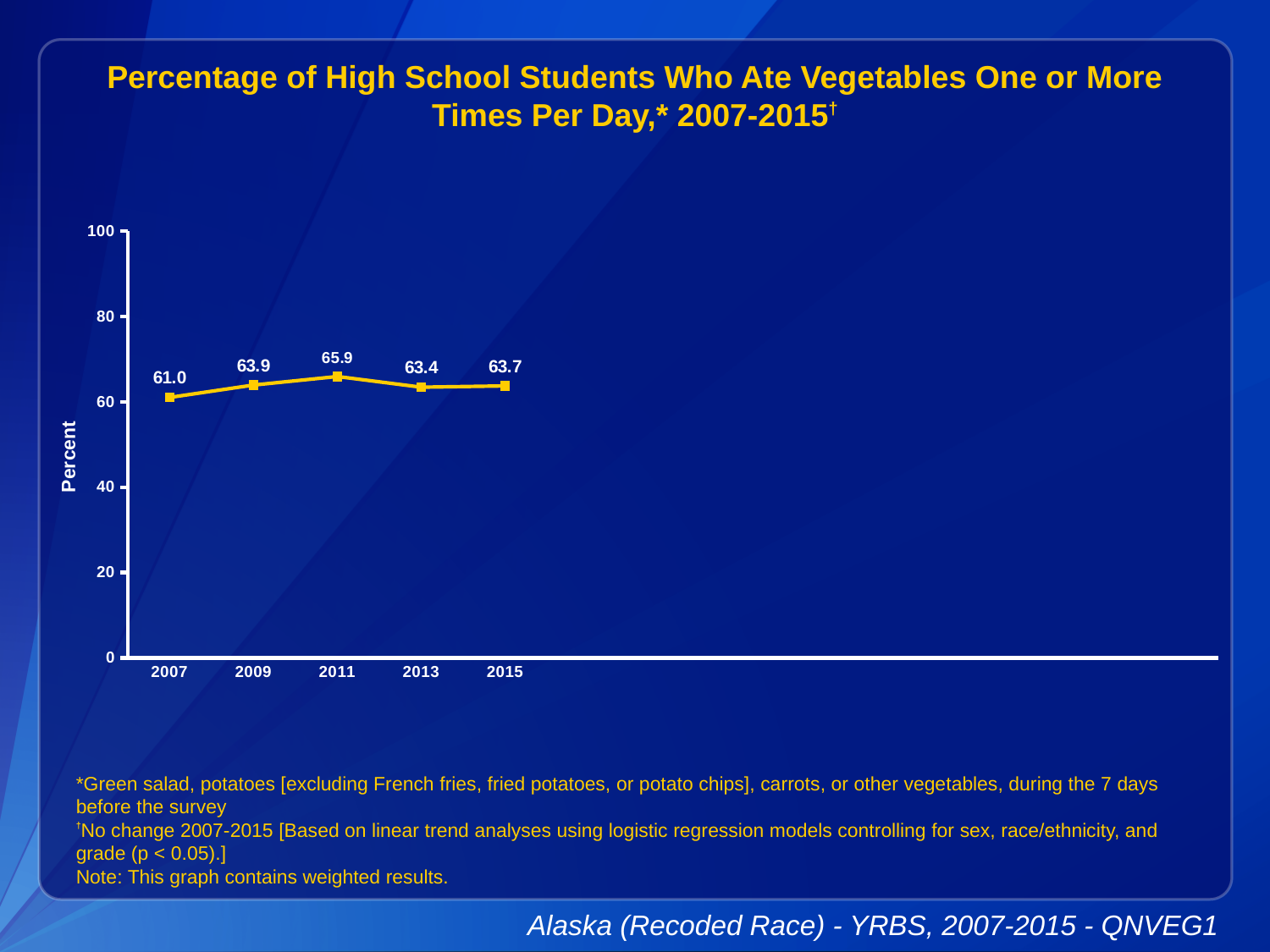
Which year has the highest value? 2011 What is the value for 2011? 65.9 How many years are plotted on the chart? 5 What is the value for 2015? 63.7 Does the value rise or fall from 2007 to 2011? rise What is the value for 2007? 61.0 Is the value for 2013 greater or less than 80? less Which year has the lowest value? 2007 Which is larger, the value for 2009 or the value for 2013? 2009 What is the label on the y axis? Percent What kind of chart is shown? line chart What is the difference between the values for 2011 and 2007? 4.9